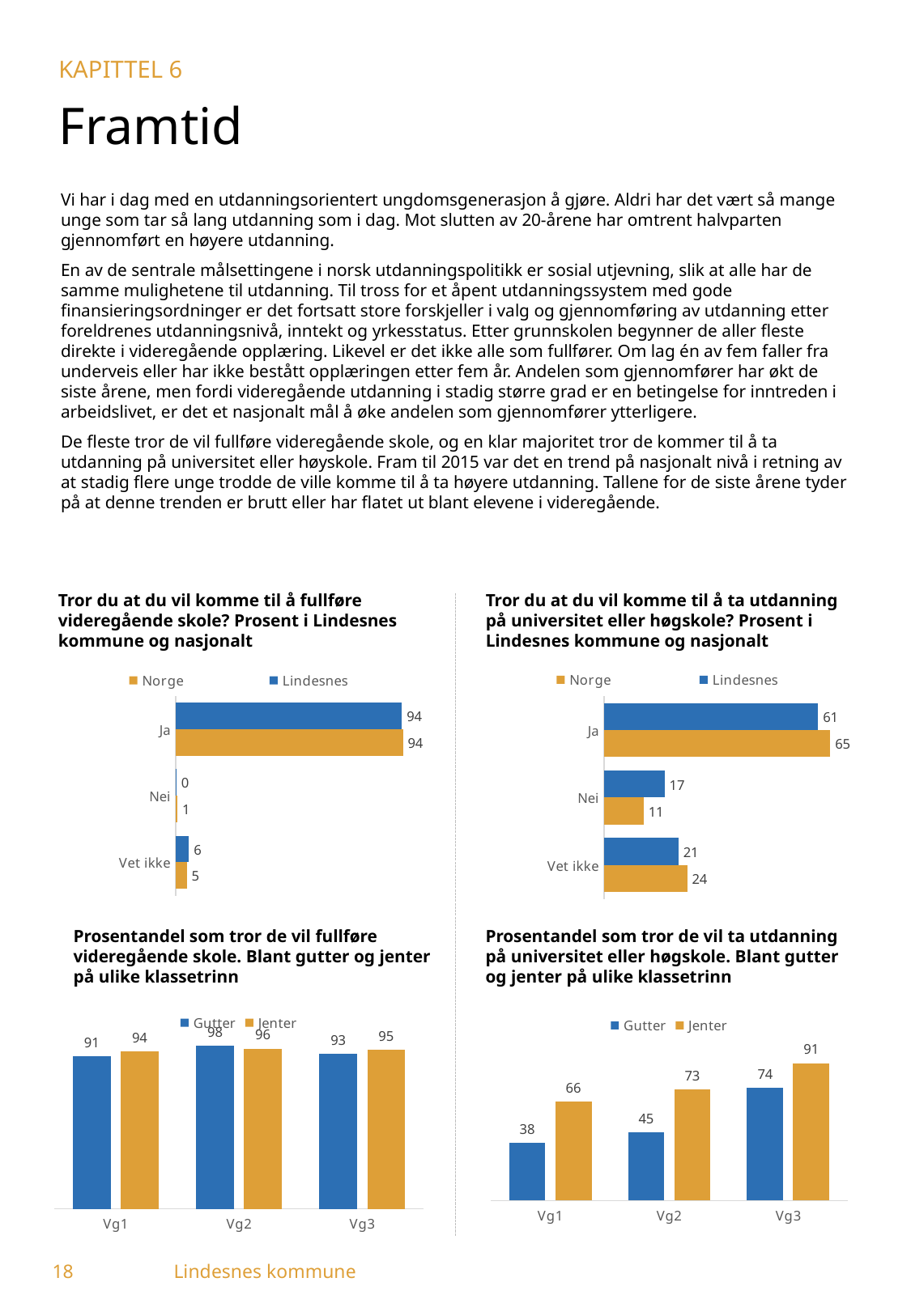
In the bottom-right chart (Prosentandel som tror de vil ta utdanning på universitet eller høgskole), do the Gutter values rise or fall from Vg1 to Vg3? rise In the bottom-right chart (Prosentandel som tror de vil ta utdanning på universitet eller høgskole), what is the difference between Jenter and Gutter at Vg2? 28 In the bottom-right chart (Prosentandel som tror de vil ta utdanning på universitet eller høgskole), what is the value for Gutter at Vg1? 38 In the top-left chart (Tror du at du vil komme til å fullføre videregående skole?), what is the difference between the Norge and Lindesnes values for 'Nei'? 1 In the bottom-left chart (Prosentandel som tror de vil fullføre videregående skole), which is larger at Vg3: Gutter or Jenter? Jenter In the top-right chart (Tror du at du vil komme til å ta utdanning på universitet eller høgskole?), what is the value for Lindesnes for 'Nei'? 17 In the top-right chart (Tror du at du vil komme til å ta utdanning på universitet eller høgskole?), what is the value for Norge for 'Ja'? 65 What kind of chart is the top-left chart (Tror du at du vil komme til å fullføre videregående skole?)? bar chart In the bottom-left chart (Prosentandel som tror de vil fullføre videregående skole), which class level has the highest value for Gutter? Vg2 In the top-left chart (Tror du at du vil komme til å fullføre videregående skole?), what is the value for Lindesnes for 'Vet ikke'? 6 How many series does the legend list in the bottom-left chart (Prosentandel som tror de vil fullføre videregående skole)? 2 In the top-right chart (Tror du at du vil komme til å ta utdanning på universitet eller høgskole?), which category has the lowest value for Norge? Nei